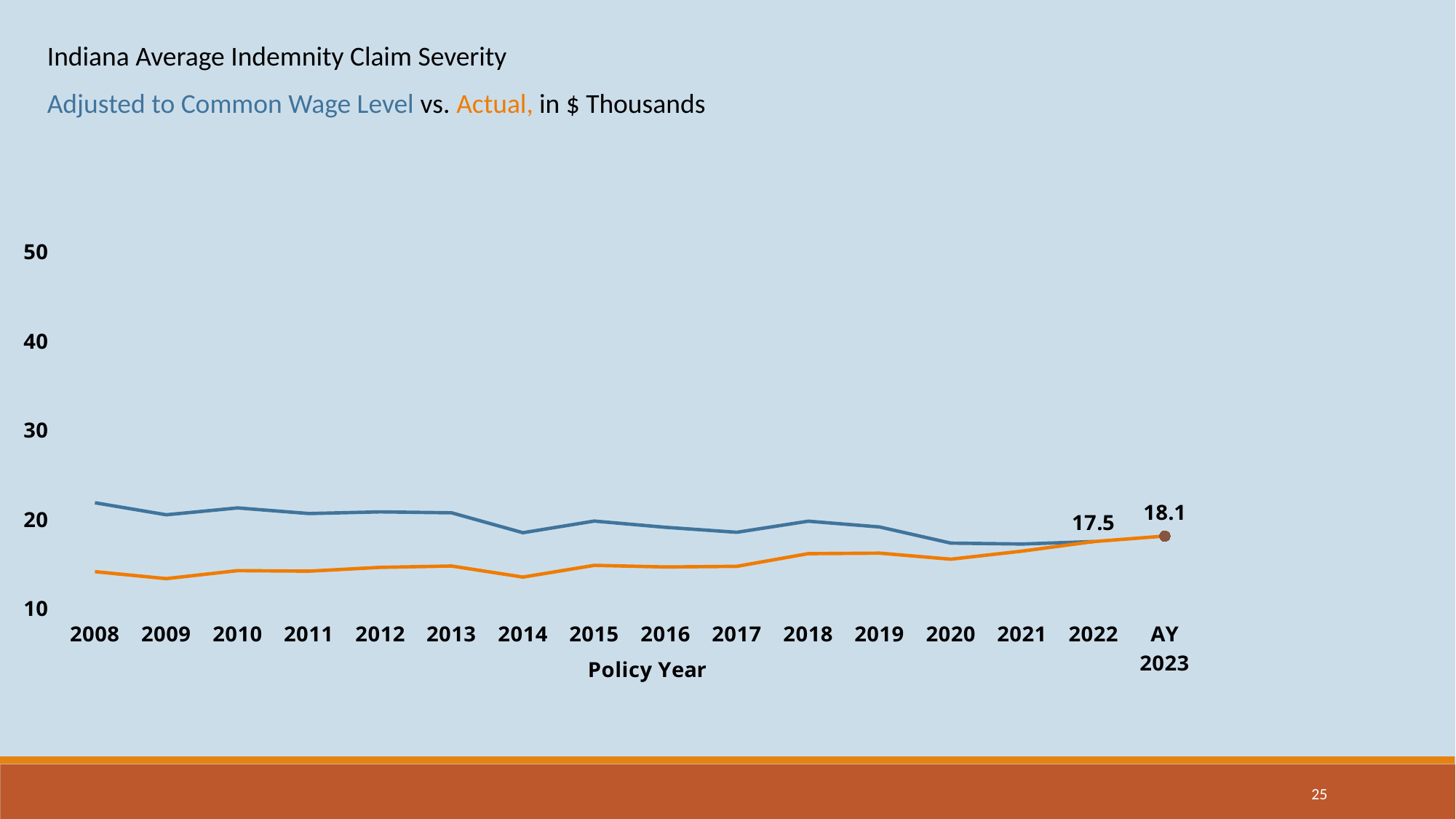
Is the Adjusted to Common Wage Level value for 2008 greater or less than 20? greater Does the Actual series generally rise or fall from 2008 to AY 2023? rise Is the Adjusted to Common Wage Level value for 2014 greater or less than 20? less What is the difference between the labelled values at AY 2023 and 2022? 0.6 In 2008, which series has the higher value: Adjusted to Common Wage Level or Actual? Adjusted to Common Wage Level How many series are plotted on the chart? 2 How many policy years are shown along the x axis? 16 What value is labelled at 2022 on the chart? 17.5 Is the Actual value for 2008 greater or less than 20? less What value is labelled at AY 2023 on the chart? 18.1 What is the x-axis title of the chart? Policy Year What type of chart is shown on the slide? line chart